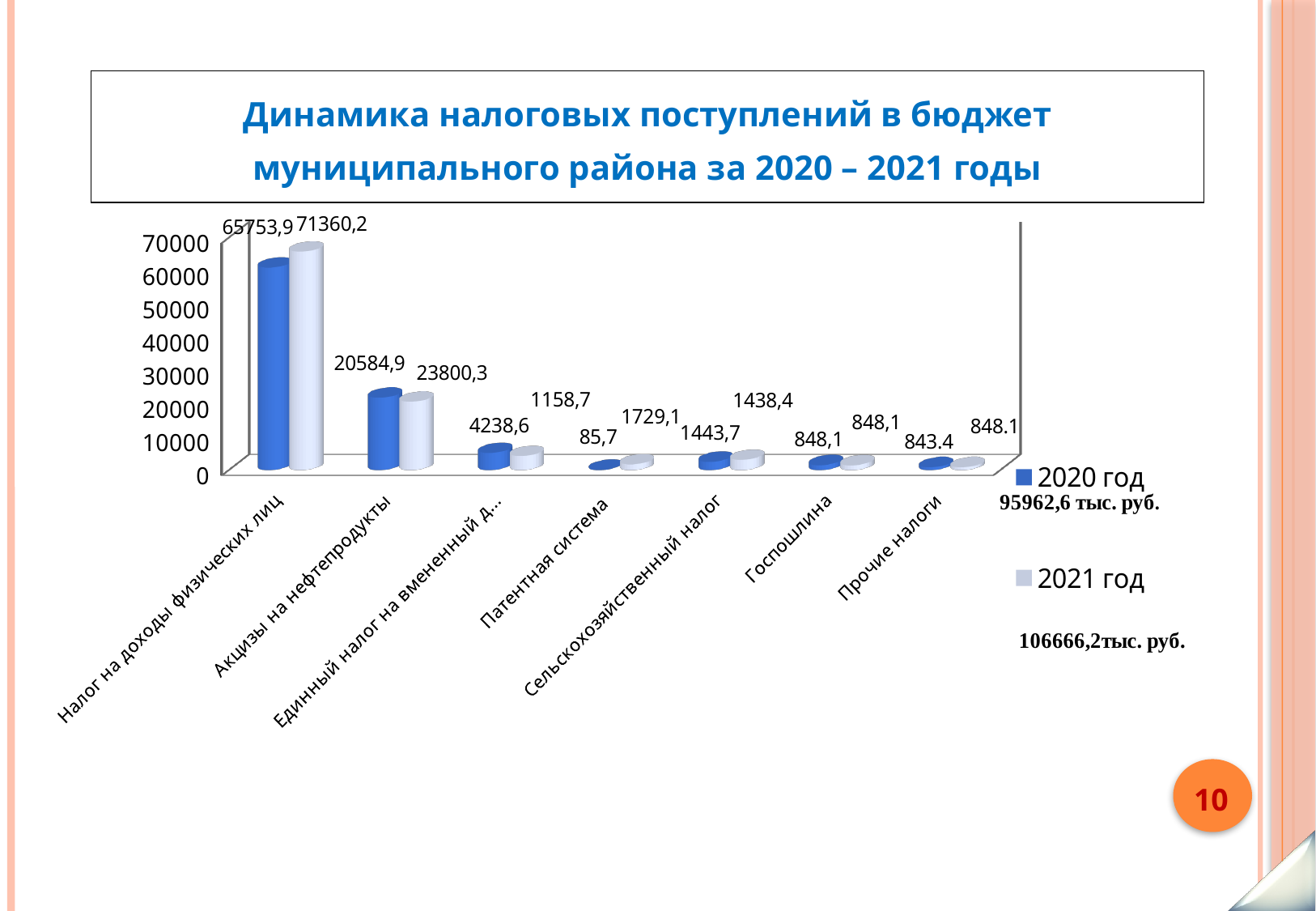
What is the value for Акцизы на нефтепродукты in the 2021 год series? 23800,3 What is the difference between the 2021 год and 2020 год values for Налог на доходы физических лиц? 5606,3 Which category has the highest value in the 2021 год series? Налог на доходы физических лиц What is the value for Госпошлина in the 2021 год series? 848,1 What kind of chart is shown on the slide? Bar chart How many series does the legend list? 2 Which category has the lowest value in the 2020 год series? Патентная система What is the value for Налог на доходы физических лиц in the 2021 год series? 71360,2 How many categories are shown on the x axis? 7 What is the value for Налог на доходы физических лиц in the 2020 год series? 65753,9 What is the value for Патентная система in the 2020 год series? 85,7